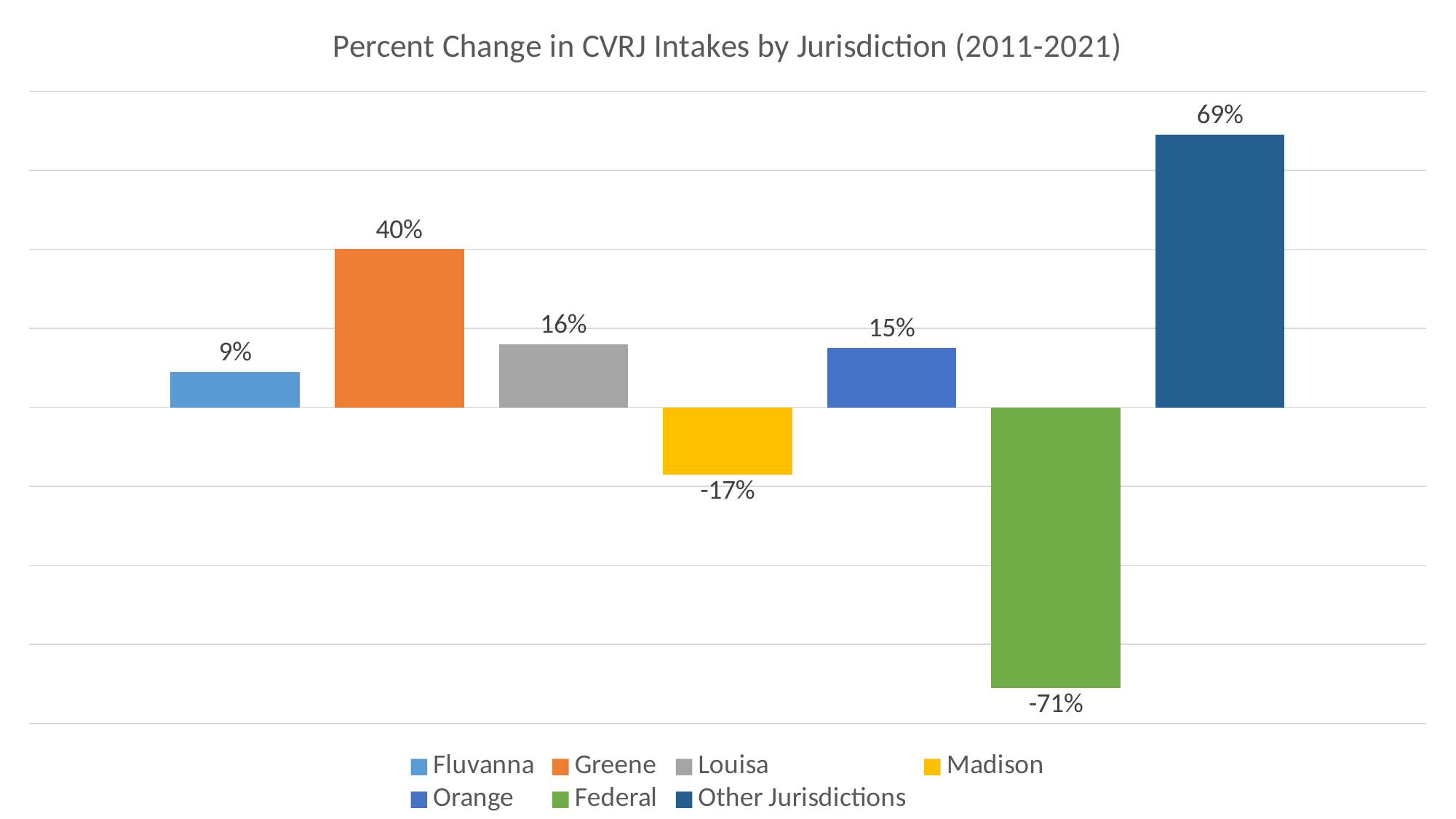
What is the title of the chart? Percent Change in CVRJ Intakes by Jurisdiction (2011-2021) What is the percent change in CVRJ intakes for Greene? 40% Which has a larger percent change in CVRJ intakes, Louisa or Fluvanna? Louisa Which jurisdiction has the highest percent change in CVRJ intakes? Other Jurisdictions What type of chart is shown on the slide? Bar chart What is the percent change in CVRJ intakes for Fluvanna? 9% How many jurisdictions are shown in the chart? 7 Which jurisdiction has the lowest percent change in CVRJ intakes? Federal What is the percent change in CVRJ intakes for Federal? -71% What is the difference between the percent change for Other Jurisdictions and Greene? 29% What colour is the bar for Madison? Yellow What is the percent change in CVRJ intakes for Madison? -17%